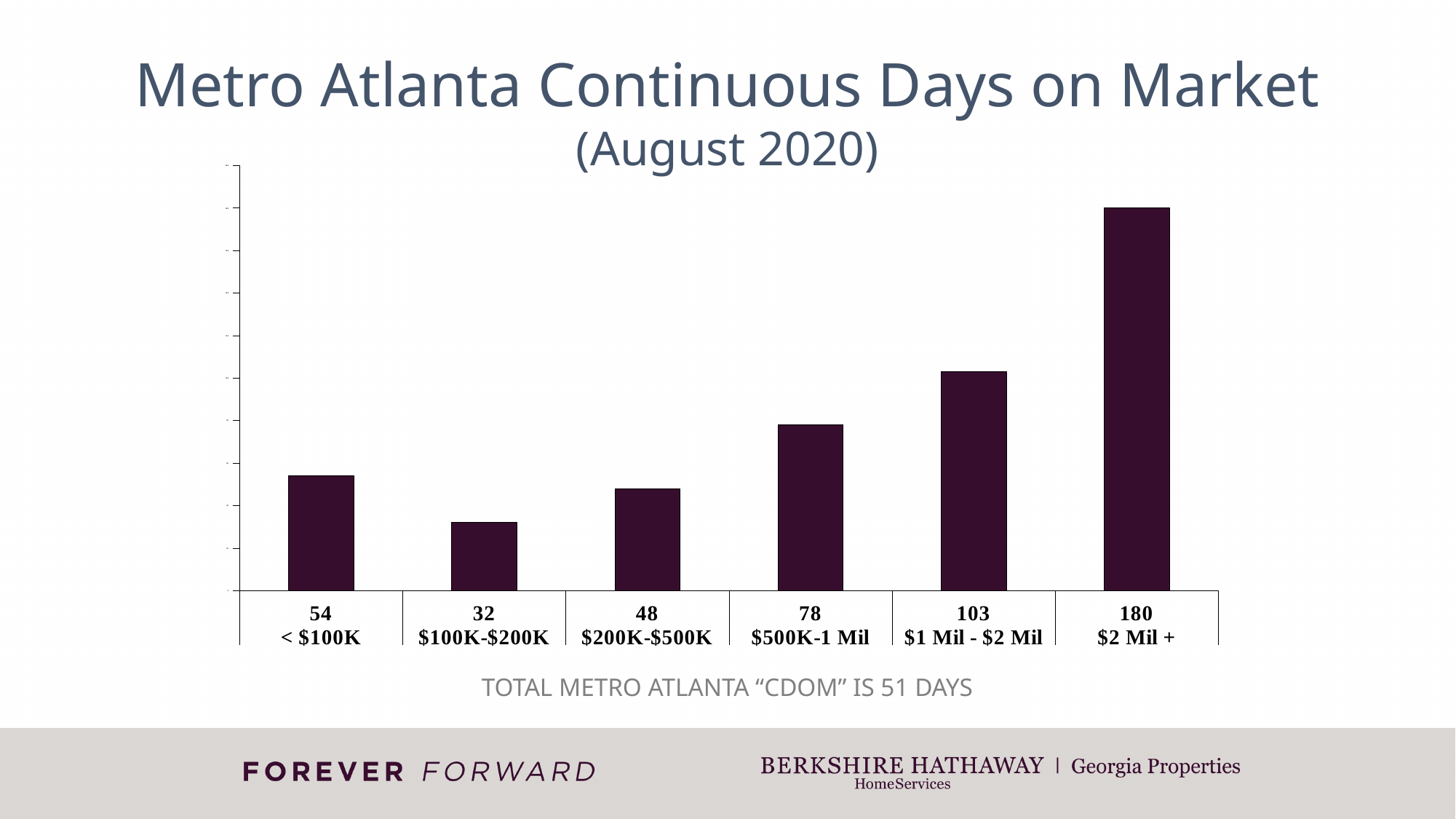
Which has more continuous days on market, < $100K or $200K-$500K? < $100K Which price range has the highest continuous days on market? $2 Mil + What kind of chart is shown on the slide? Bar chart How many price range categories are shown in the chart? 6 Which price range has the lowest continuous days on market? $100K-$200K What is the continuous days on market value for the $1 Mil - $2 Mil price range? 103 What is the difference in days on market between the < $100K and $200K-$500K price ranges? 6 What is the continuous days on market value for the < $100K price range? 54 According to the note below the chart, what is the total Metro Atlanta CDOM? 51 days What is the difference in days on market between the $2 Mil + and $1 Mil - $2 Mil price ranges? 77 What is the continuous days on market value for the $500K-1 Mil price range? 78 From the $100K-$200K category onward, do the values rise or fall as the price range increases? Rise